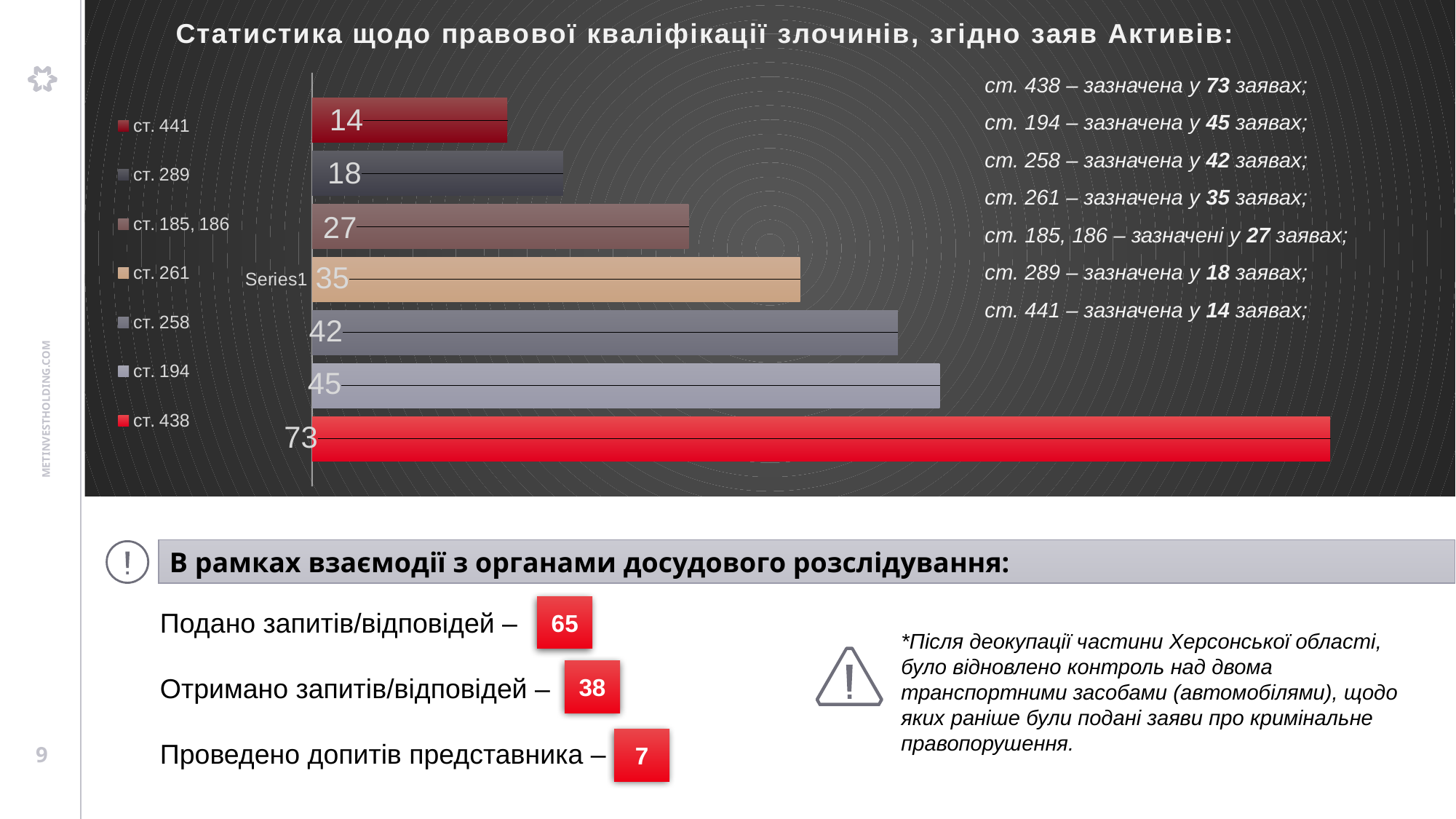
What value is shown for ст. 438 in the chart? 73 How many entries does the chart legend list? 7 What is the difference between the values for ст. 289 and ст. 441? 4 What value is shown for ст. 185, 186 in the chart? 27 How many categories are plotted in the chart? 7 What value is shown for ст. 261 in the chart? 35 Which category has the highest value in the chart? ст. 438 Which category has the lowest value in the chart? ст. 441 What colour is the bar for ст. 438? red What type of chart is shown on the slide? bar chart Which is larger, the value for ст. 258 or the value for ст. 261? ст. 258 What is the difference between the values for ст. 438 and ст. 194? 28